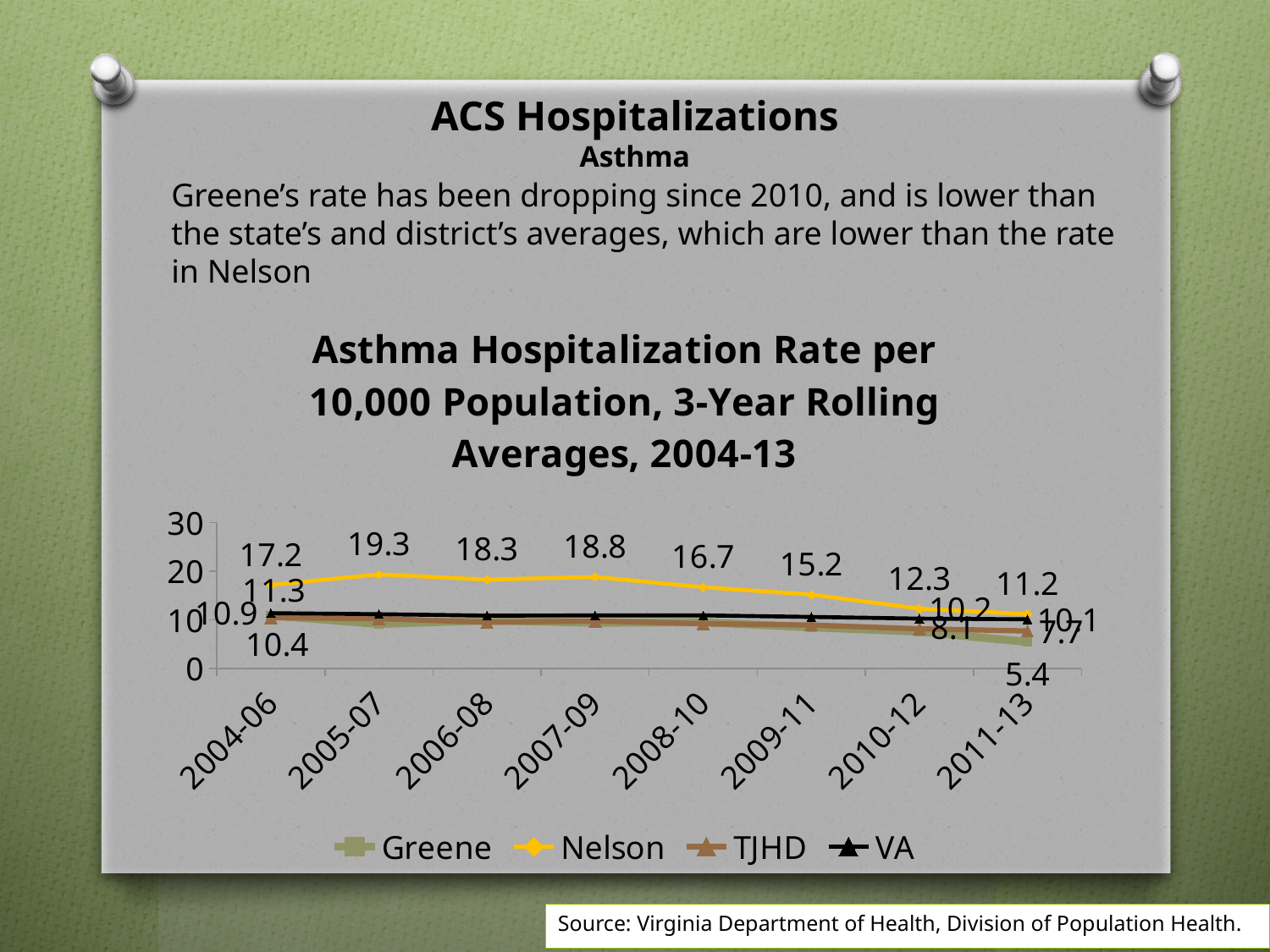
What is the difference between the Nelson rate in 2005-07 and in 2011-13? 8.1 Does the Nelson rate rise or fall from 2007-09 to 2011-13? fall How many time periods are plotted along the x axis? 8 What is the Nelson asthma hospitalization rate for 2005-07? 19.3 What is the Greene asthma hospitalization rate for 2011-13? 5.4 In which period is the Nelson rate highest? 2005-07 In which period is the Nelson rate lowest? 2011-13 What kind of chart is shown on the slide? line chart Which is larger in 2011-13, the Nelson rate or the Greene rate? Nelson What is the Nelson asthma hospitalization rate for 2011-13? 11.2 How many series does the legend list? 4 Is the VA rate for 2007-09 greater or less than 20? less